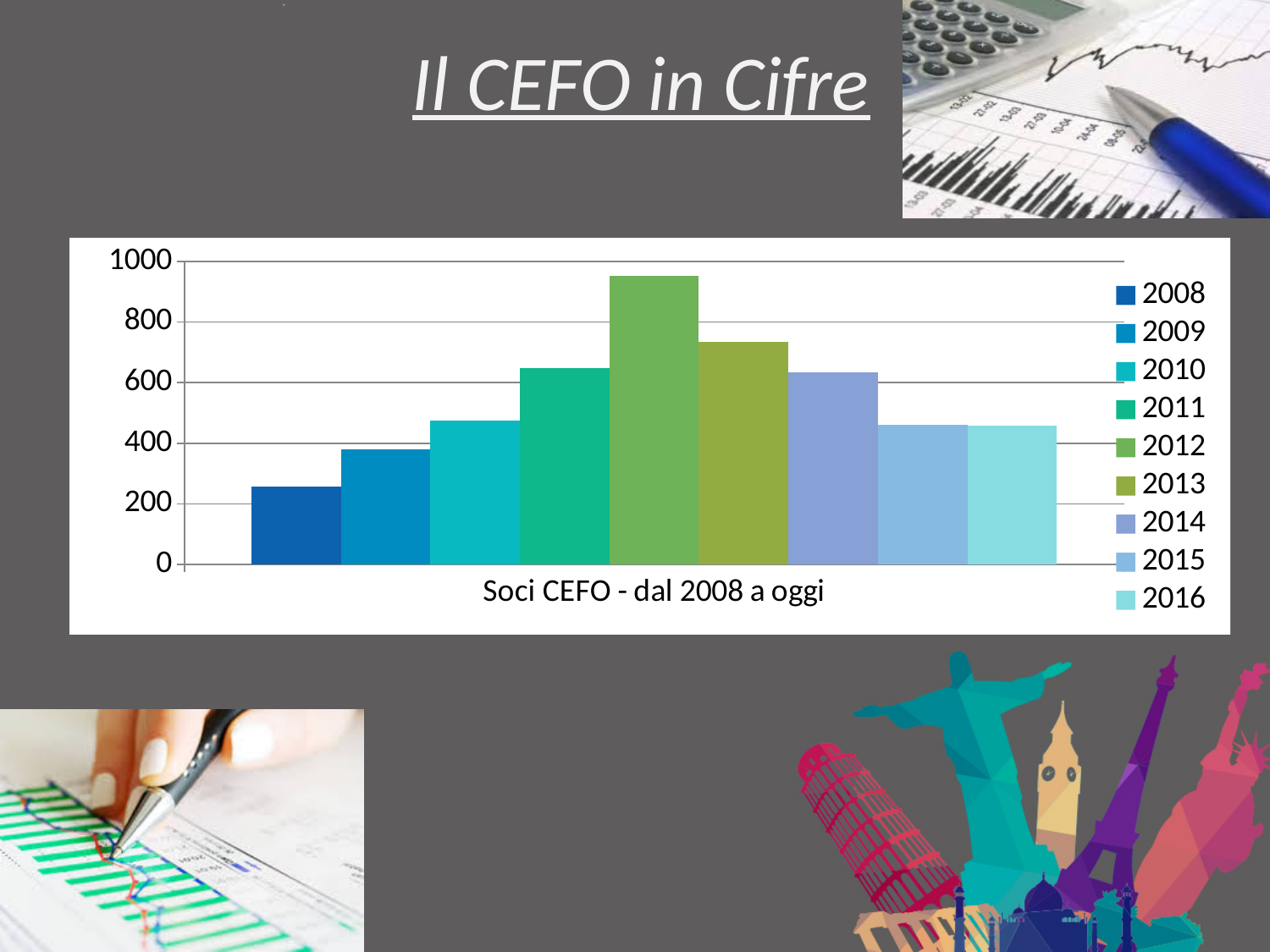
Which year has the highest bar? 2012 Is the value for 2013 greater or less than 800? less How many bars are plotted in the chart? 9 Which year has the lowest bar? 2008 What kind of chart is shown on the slide? bar chart Is the value for 2015 greater or less than 400? greater What is the title of the chart? Soci CEFO - dal 2008 a oggi Which is larger, the value for 2012 or the value for 2013? 2012 How many entries does the chart legend list? 9 Is the value for 2009 greater or less than 400? less Do the values rise or fall from 2008 to 2012? rise